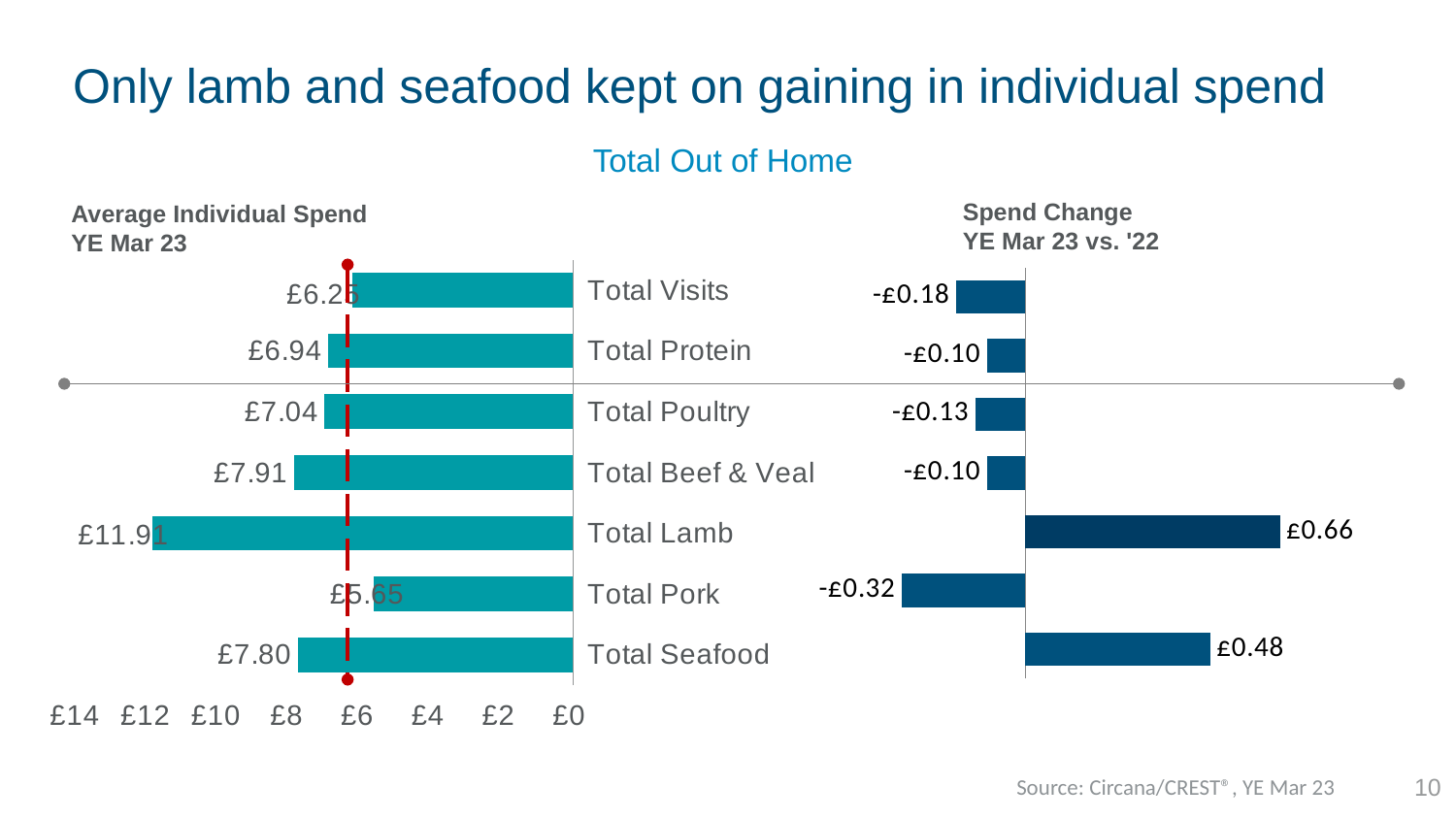
In the Spend Change YE Mar 23 vs. '22 chart, which is larger, the spend change for Total Lamb or Total Seafood? Total Lamb In the Spend Change YE Mar 23 vs. '22 chart, what is the value for Total Lamb? £0.66 In the Spend Change YE Mar 23 vs. '22 chart, what is the value for Total Pork? -£0.32 In the Average Individual Spend YE Mar 23 chart, what is the value for Total Beef & Veal? £7.91 In the Spend Change YE Mar 23 vs. '22 chart, which category has the largest decline in spend? Total Pork In the Average Individual Spend YE Mar 23 chart, what is the difference between Total Beef & Veal and Total Poultry? £0.87 In the Average Individual Spend YE Mar 23 chart, what is the value for Total Protein? £6.94 In the Average Individual Spend YE Mar 23 chart, which category has the highest average individual spend? Total Lamb In the Average Individual Spend YE Mar 23 chart, what is the value for Total Seafood? £7.80 In the Average Individual Spend YE Mar 23 chart, which category has the lowest average individual spend? Total Pork How many categories are shown in the Spend Change YE Mar 23 vs. '22 chart? 7 In the Average Individual Spend YE Mar 23 chart, is the value for Total Lamb greater or less than £10? greater